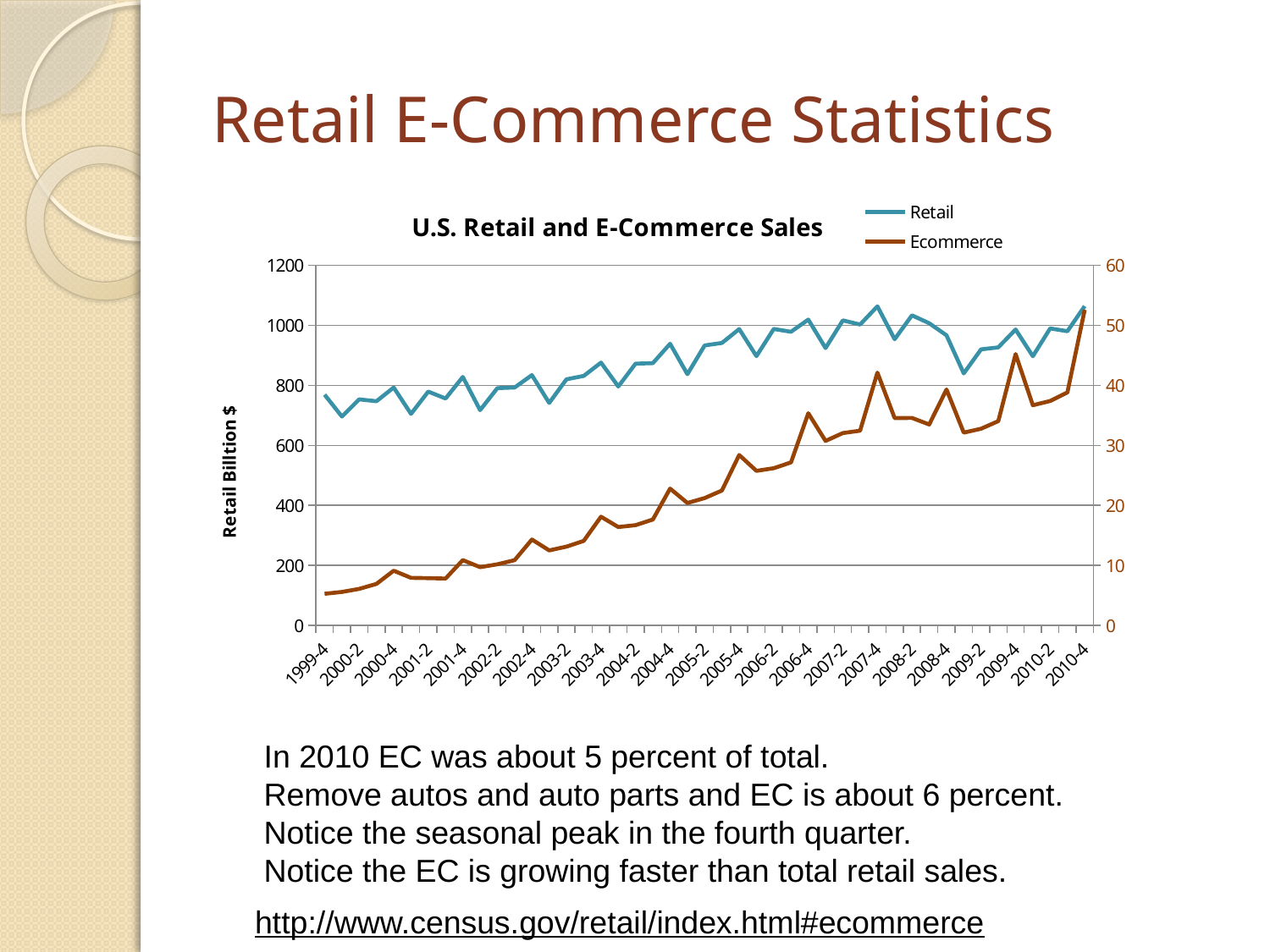
What kind of chart is shown on the slide? Line chart What is the label on the left vertical axis? Retail Billtion $ Does the Ecommerce series generally rise or fall from 1999-4 to 2010-4? Rise What is the title of the chart? U.S. Retail and E-Commerce Sales Which series is plotted in blue? Retail How many series does the legend list? 2 At which quarter is the Ecommerce series at its lowest value? 1999-4 Which is larger, the Retail value for 2007-4 or the Retail value for 2009-2? 2007-4 Is the Ecommerce value for 1999-4 greater or less than 10 on the right axis? less Is the Retail value for 2007-4 greater or less than 1000? greater At which quarter does the Ecommerce series reach its highest value? 2010-4